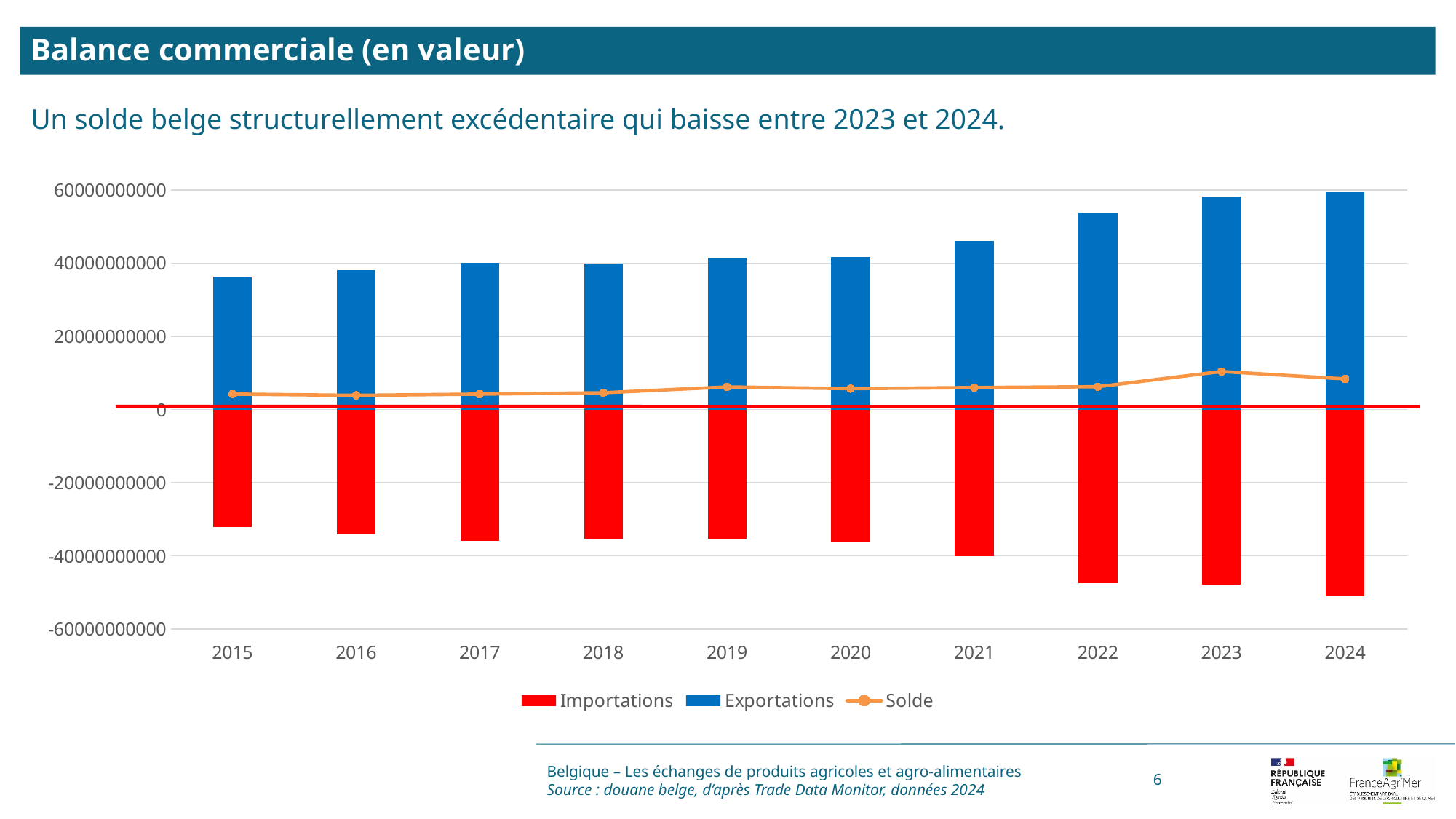
Is the Exportations value for 2015 greater or less than 40000000000? less Do the Exportations values generally rise or fall from 2015 to 2024? rise How many series does the chart legend list? 3 Is the Exportations value for 2022 greater or less than 40000000000? greater How many years are shown on the x axis of the chart? 10 Is the Solde value for 2023 greater or less than 20000000000? less What colour represents Exportations in the chart? blue Which year has the highest Solde value? 2023 Which is larger, the Solde value for 2023 or the Solde value for 2019? 2023 What kind of chart is shown on the slide? bar chart with a line Which year has the lowest Exportations value? 2015